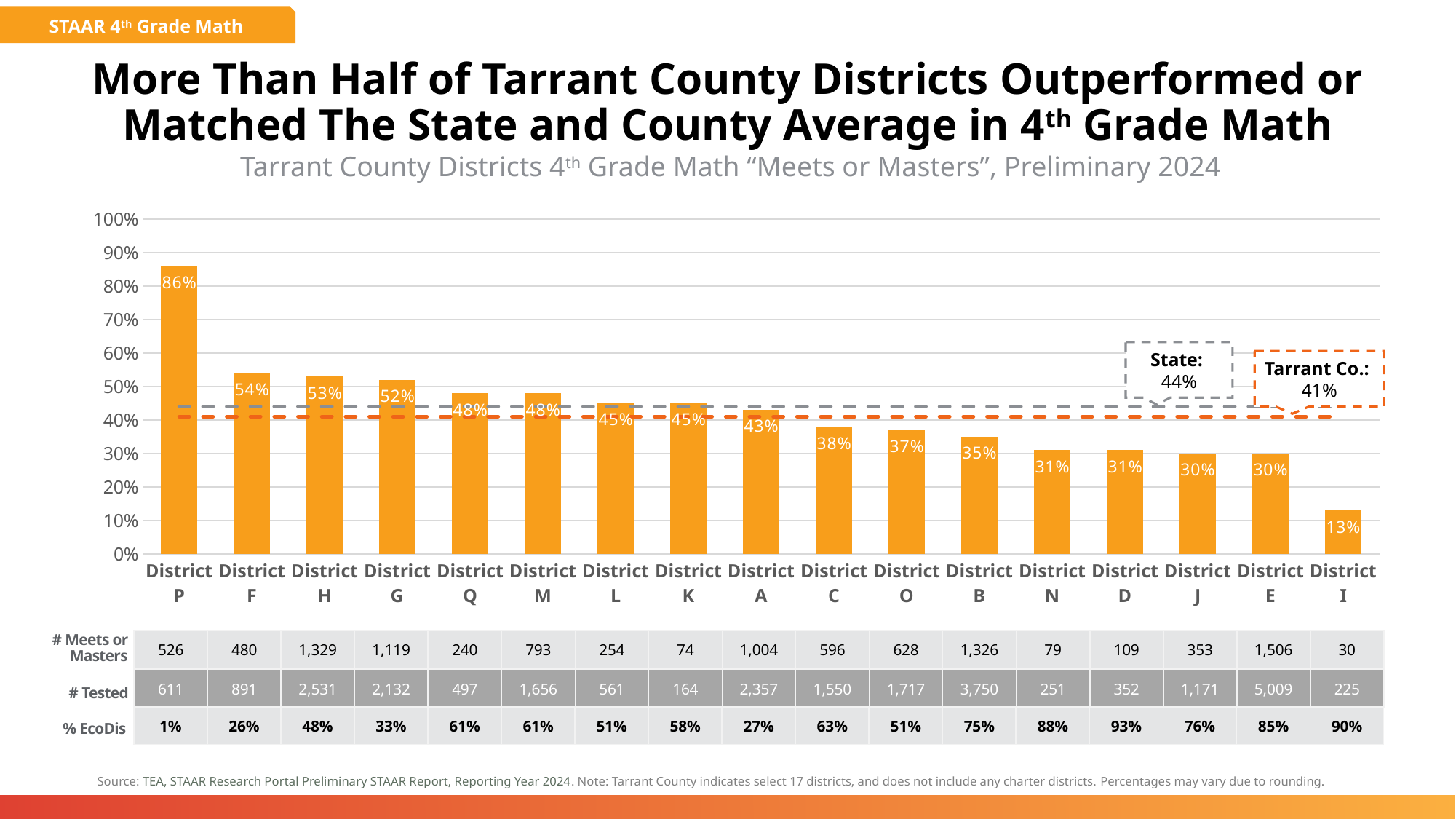
What is the "Meets or Masters" percentage for District I? 13% What is the difference between the "Meets or Masters" percentages of District P and District F? 32% What is the "Meets or Masters" percentage for District C? 38% What is the "Meets or Masters" percentage for District P? 86% Which has a higher "Meets or Masters" percentage, District A or District B? District A What is the State average shown by the dashed line? 44% What kind of chart is shown on the slide? Bar chart Which district has the highest "Meets or Masters" percentage? District P Do the bar values rise or fall from left to right along the x axis? Fall How many districts are shown in the chart? 17 Which district has the lowest "Meets or Masters" percentage? District I What is the Tarrant Co. average shown by the dashed line? 41%